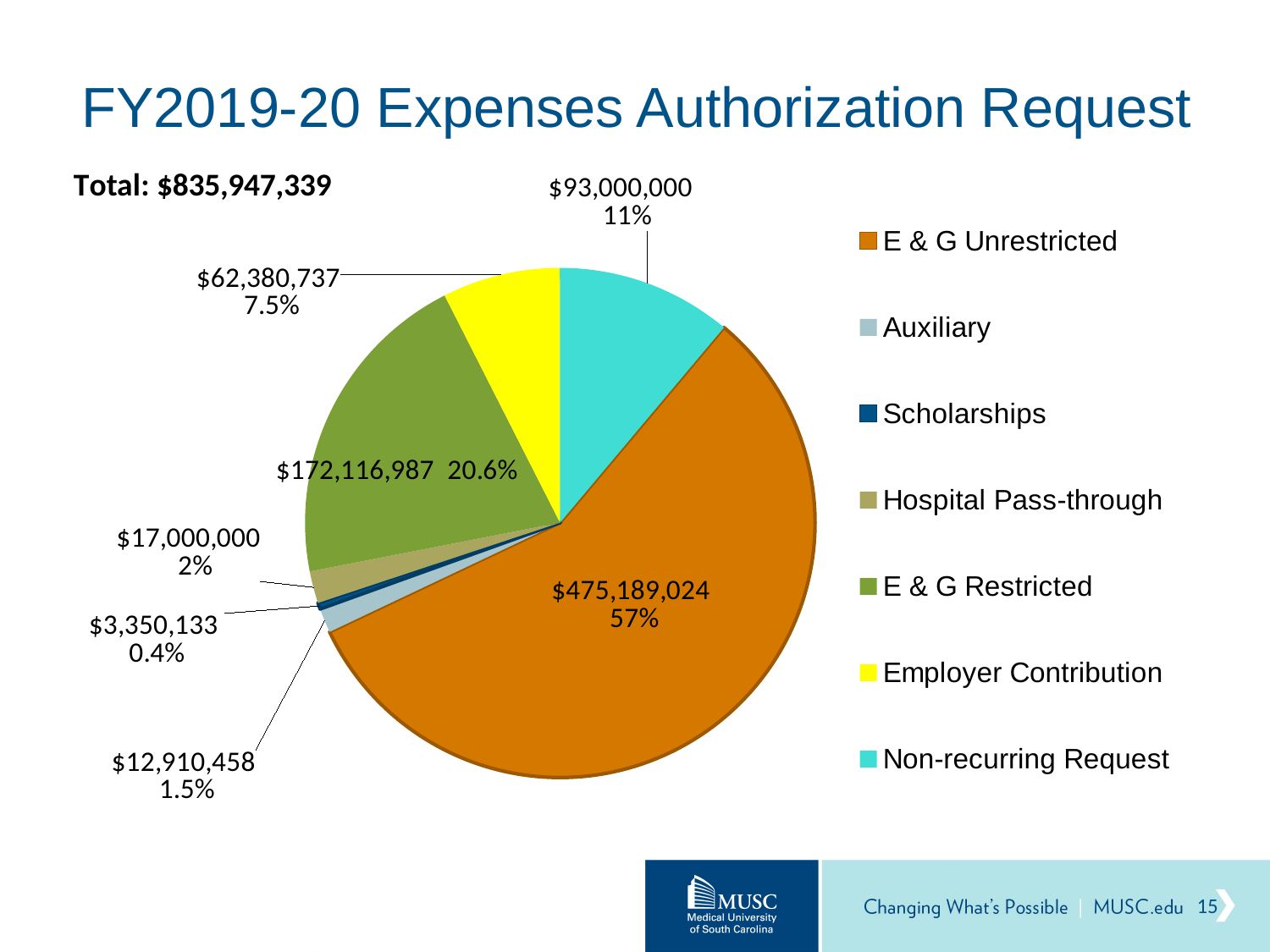
What share of the pie does E & G Restricted represent? 20.6% How many categories does the legend list? 7 Which is larger, Non-recurring Request or Employer Contribution? Non-recurring Request Which category has the largest slice of the pie? E & G Unrestricted What is the value for Employer Contribution? $62,380,737 Which category has the smallest slice of the pie? Scholarships What is the value for E & G Restricted? $172,116,987 What kind of chart is shown on the slide? pie chart What share of the pie does Auxiliary represent? 1.5% What is the value for Non-recurring Request? $93,000,000 What is the value for Scholarships? $3,350,133 What is the value for E & G Unrestricted? $475,189,024